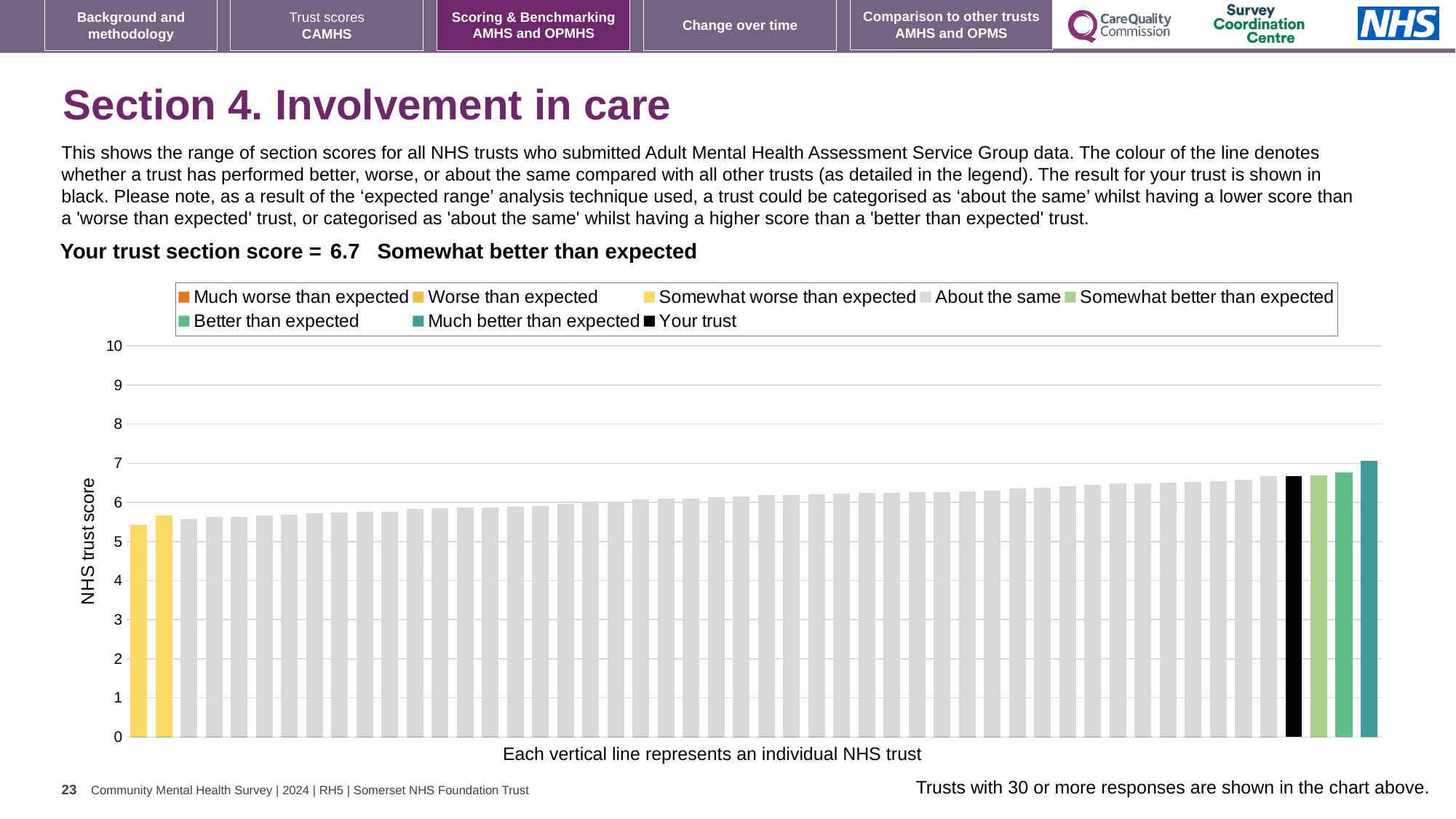
Do the bar values rise or fall from left to right across the chart? rise What kind of chart is shown on the slide? bar chart Is the value of the leftmost bar greater or less than 6? less What is the label on the vertical axis of the chart? NHS trust score What colour is the bar representing your trust? black Which is larger, the leftmost bar or the rightmost bar? the rightmost bar How many entries does the chart legend list? 8 Is the value of the black 'Your trust' bar greater or less than 6? greater What is the highest value shown on the vertical axis? 10 What is the section score for your trust? 6.7 Which category does your trust's section score fall into? Somewhat better than expected Is the value of the rightmost bar greater or less than 6? greater